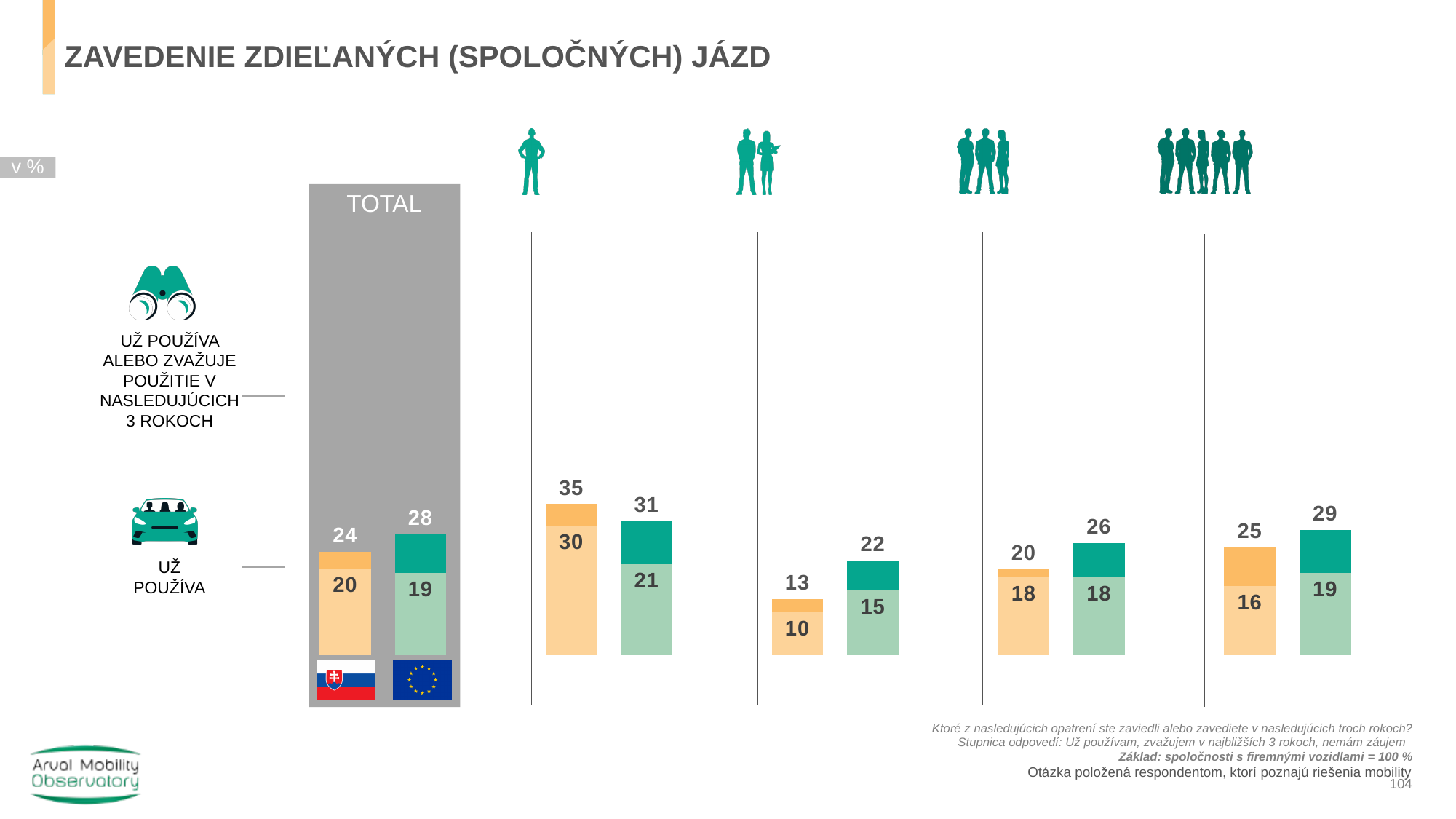
In the rightmost group (five-person icon), which bar is higher, Slovakia or EU? EU Across all groups, which bar has the highest value printed above it? Slovakia bar in the single-person group (35) Which two flags are shown under the TOTAL bars? Slovakia and the European Union What kind of chart is shown on the slide? bar chart In the second group to the right of TOTAL (two-person icon), what is the 'UŽ POUŽÍVA' value for the Slovakia (orange) bar? 10 In the first group to the right of TOTAL (single-person icon), what is the value printed above the Slovakia (orange) bar? 35 In the TOTAL group, what is the 'UŽ POUŽÍVA' (already uses) value for the EU bar? 19 In the TOTAL group, what is the value printed above the Slovakia (orange) bar? 24 Across all groups, which bar has the lowest value printed above it? Slovakia bar in the two-person group (13) In the two-person group, what is the difference between the EU bar total (22) and the Slovakia bar total (13)? 9 In the TOTAL group, what is the value printed above the EU (green) bar? 28 How many groups of bars are shown on the slide, including TOTAL? 5